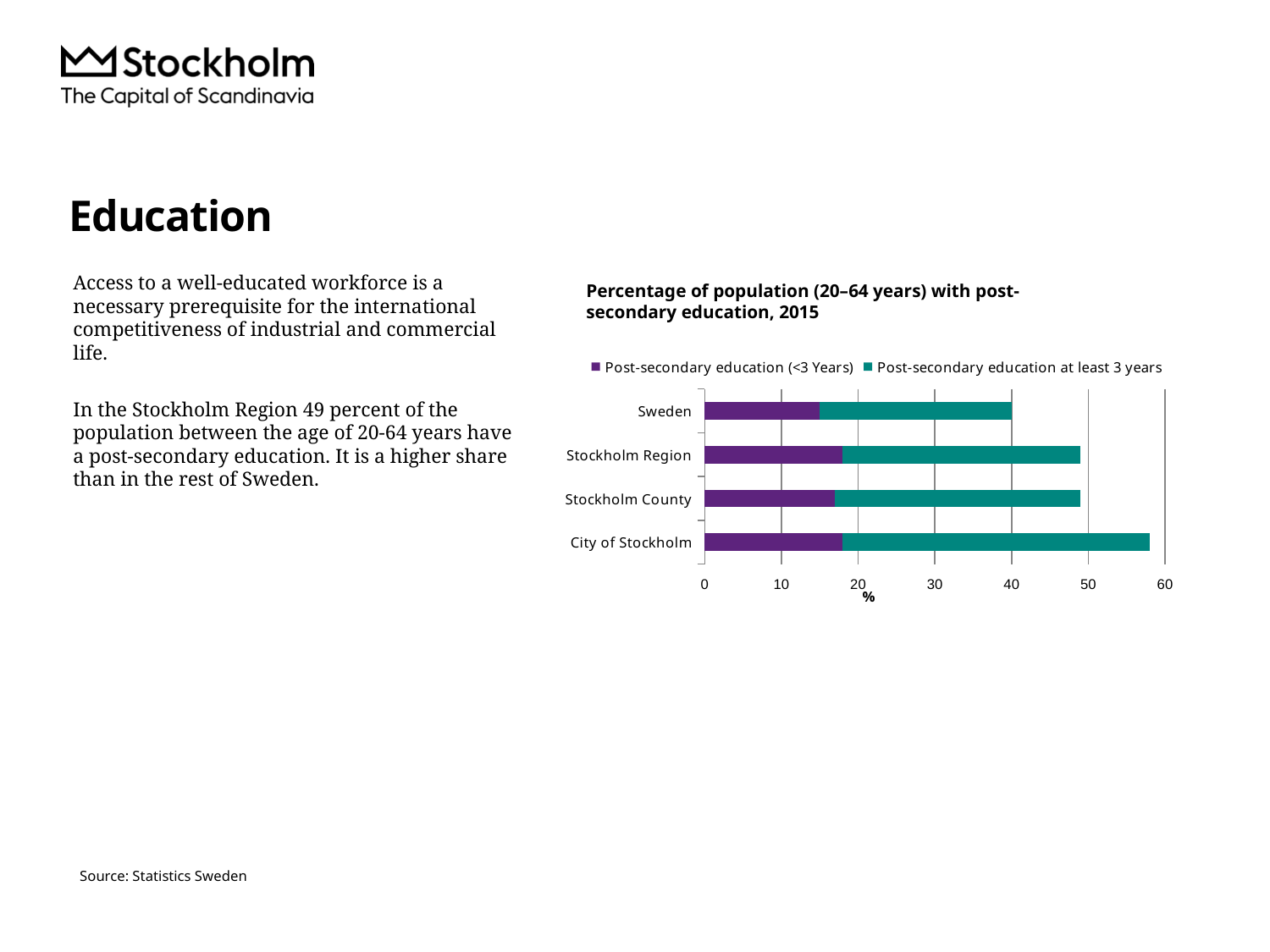
Which category has the highest total percentage of population with post-secondary education? City of Stockholm Is the total value for City of Stockholm greater or less than 60? less What kind of chart is shown on the slide? Stacked bar chart How many categories (regions) are shown on the chart? 4 Is the total value for City of Stockholm greater or less than 50? greater What is the title of the chart? Percentage of population (20–64 years) with post-secondary education, 2015 Is the value for Post-secondary education (<3 Years) in Sweden greater or less than 10? greater What label is shown on the horizontal axis of the chart? % How many series does the chart legend list? 2 Which has a larger total bar, City of Stockholm or Sweden? City of Stockholm Which category has the lowest total percentage of population with post-secondary education? Sweden